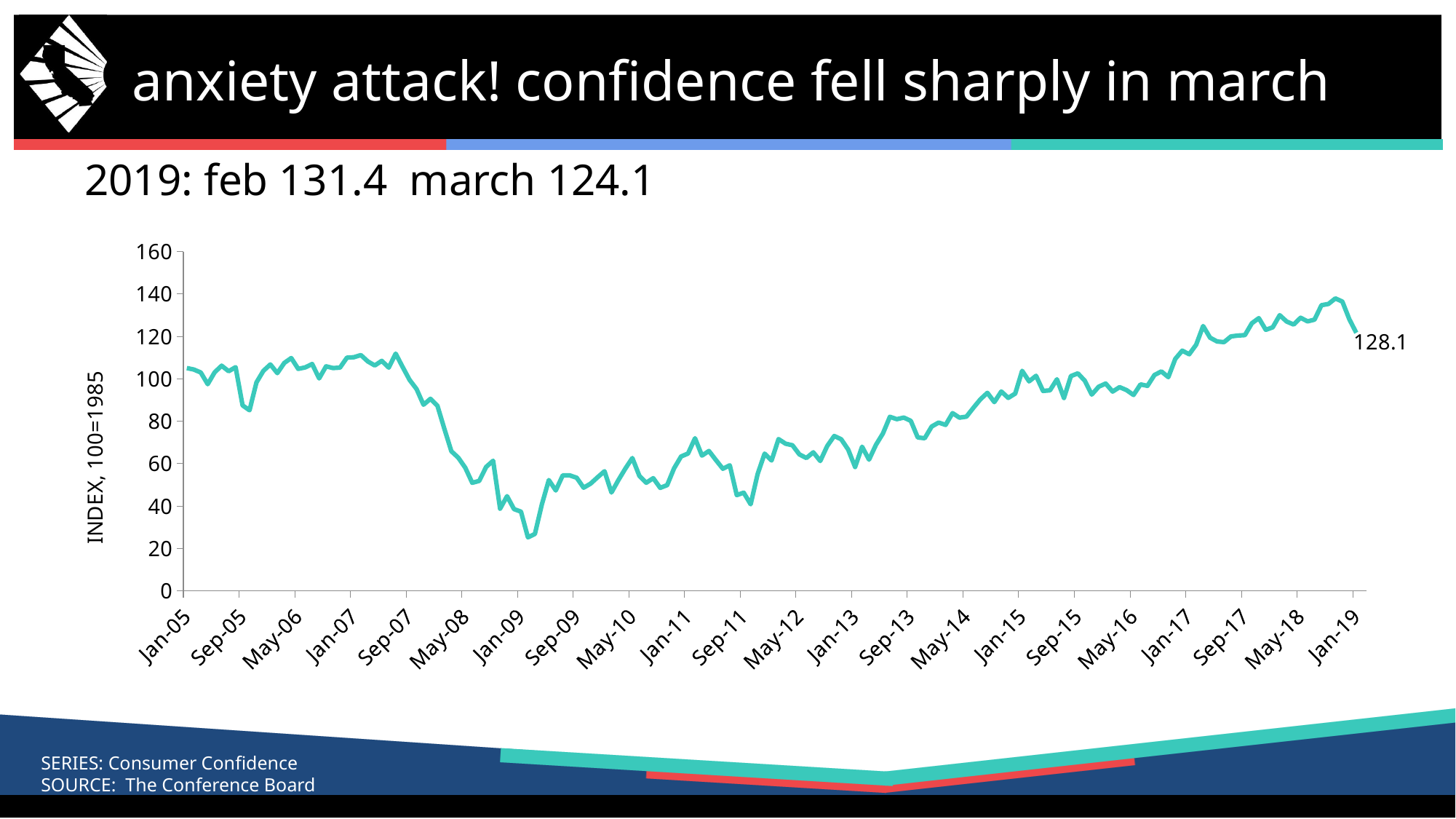
Which is larger, the value at Jan-05 or the value at Jan-09? Jan-05 How many lines are plotted on the chart? 1 In which year does the line reach its lowest point? 2009 What type of chart is shown on the slide? line chart Is the value for Sep-11 greater or less than 60? less Is the value for May-08 greater or less than 80? less In which year does the line reach its highest point? 2018 Is the value for Jan-05 greater or less than 100? greater What value is printed as the data label at the end of the line (Jan-19)? 128.1 Does the line generally rise or fall between Jan-13 and Jan-19? rise What is the title of the vertical axis? INDEX, 100=1985